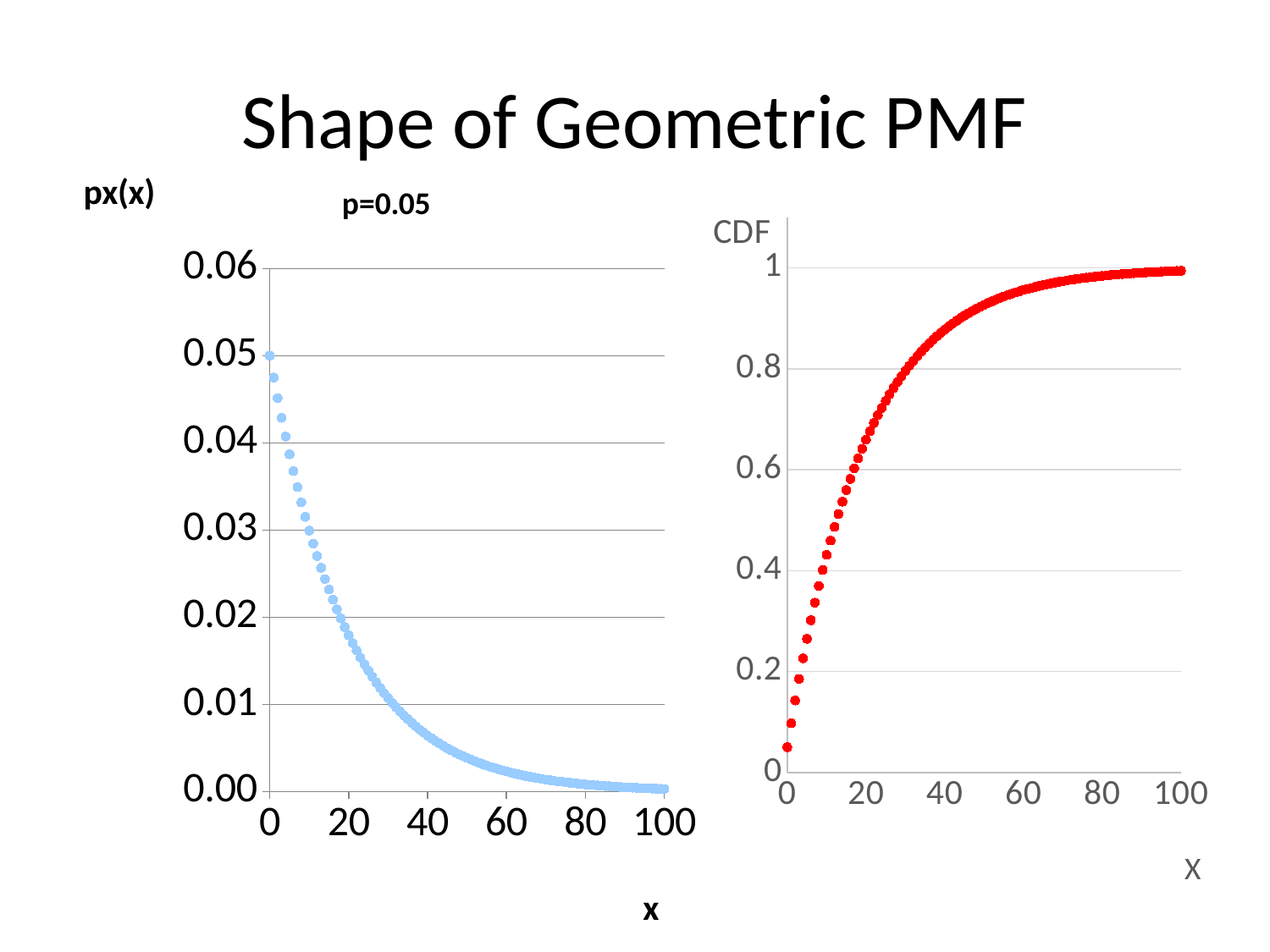
What value of p is stated for the left chart (px(x))? p=0.05 What kind of chart is the right chart (CDF vs X)? scatter chart In the left chart (px(x)), is the value at x = 0 greater or less than 0.04? greater In the right chart (CDF), do the values rise or fall as X increases? rise In the left chart (px(x)), do the values rise or fall as x increases? fall In the right chart (CDF), at which X value is the plotted value lowest? 0 In the left chart (px(x)), which is larger: the value at x = 0 or the value at x = 100? x = 0 In the right chart (CDF), is the value at X = 40 greater or less than 0.8? greater In the right chart (CDF), is the value at X = 0 greater or less than 0.2? less In the left chart (px(x)), at which x value is the plotted value highest? 0 What kind of chart is the left chart (px(x) vs x)? scatter chart